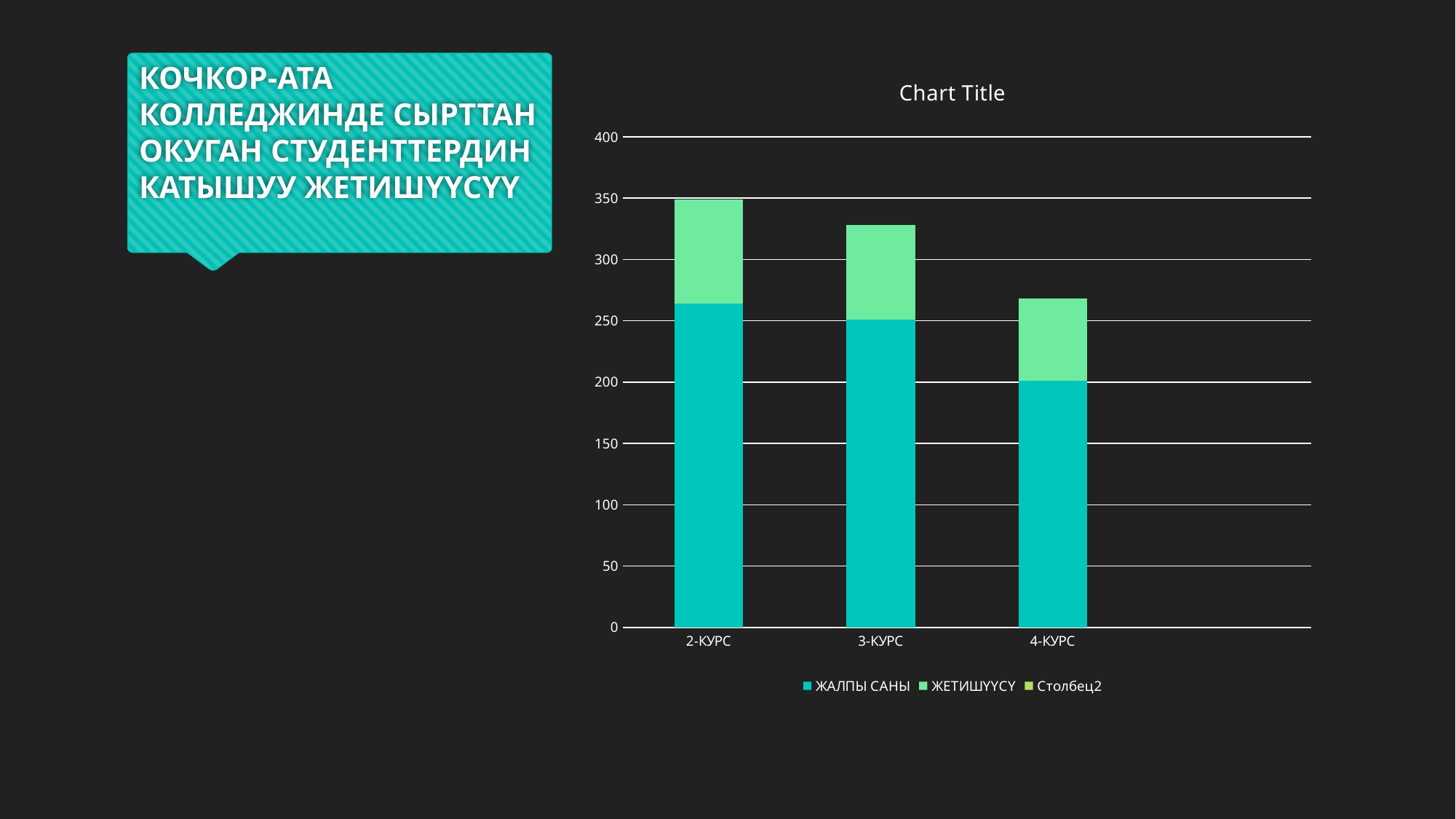
Which category has the tallest stacked bar? 2-КУРС Is the ЖАЛПЫ САНЫ value for 4-КУРС greater or less than 250? less Is the ЖАЛПЫ САНЫ value for 2-КУРС greater or less than 250? greater How many categories are shown on the x axis of the chart? 3 How many series does the chart legend list? 3 Is the total height of the stacked bar for 4-КУРС greater or less than 300? less Do the total bar heights rise or fall from 2-КУРС to 4-КУРС? fall What kind of chart is shown on the slide? Stacked bar chart Which category has the shortest stacked bar? 4-КУРС What is the title shown above the chart? Chart Title Which has a larger ЖАЛПЫ САНЫ value, 2-КУРС or 4-КУРС? 2-КУРС